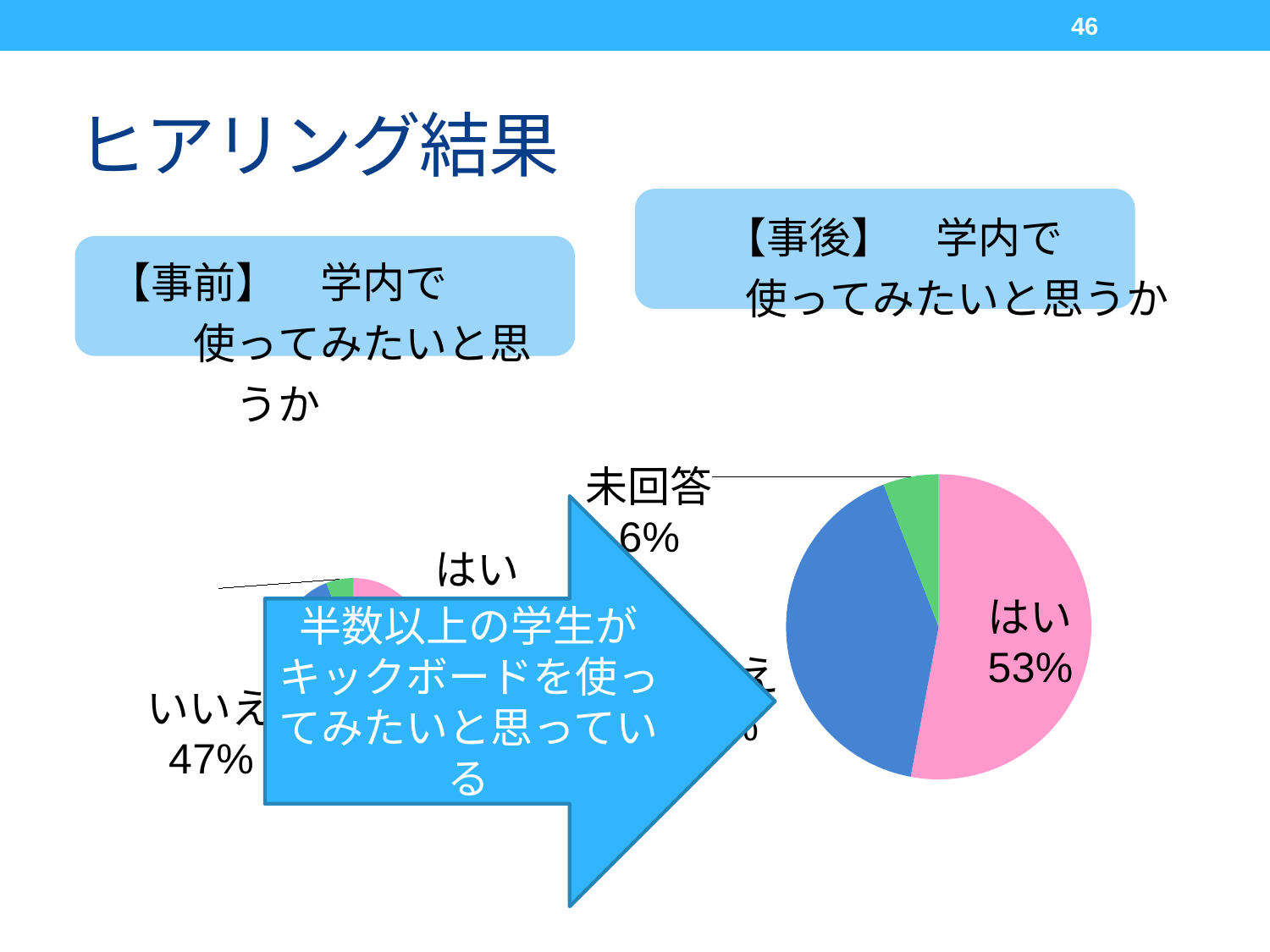
In the right-hand pie chart (【事後】), which category has the smallest slice? 未回答 What is the title of the slide containing the two pie charts? ヒアリング結果 In the right-hand pie chart (【事後】), which is larger, はい or 未回答? はい How many slices does the right-hand pie chart (【事後】) have? 3 In the right-hand pie chart (【事後】), which category has the largest slice? はい In the right-hand pie chart (【事後】), is the share for はい greater or less than 50%? greater In the right-hand pie chart (【事後】), how many percentage points larger is はい than 未回答? 47 In the right-hand pie chart (【事後】), what percentage is shown for はい? 53% In the right-hand pie chart (【事後】), what percentage is shown for 未回答? 6% In the right-hand pie chart (【事後】), what colour is the はい slice? Pink In the left-hand pie chart (【事前】), what percentage is shown for いいえ? 47% What kind of chart is the right-hand chart (【事後】)? Pie chart